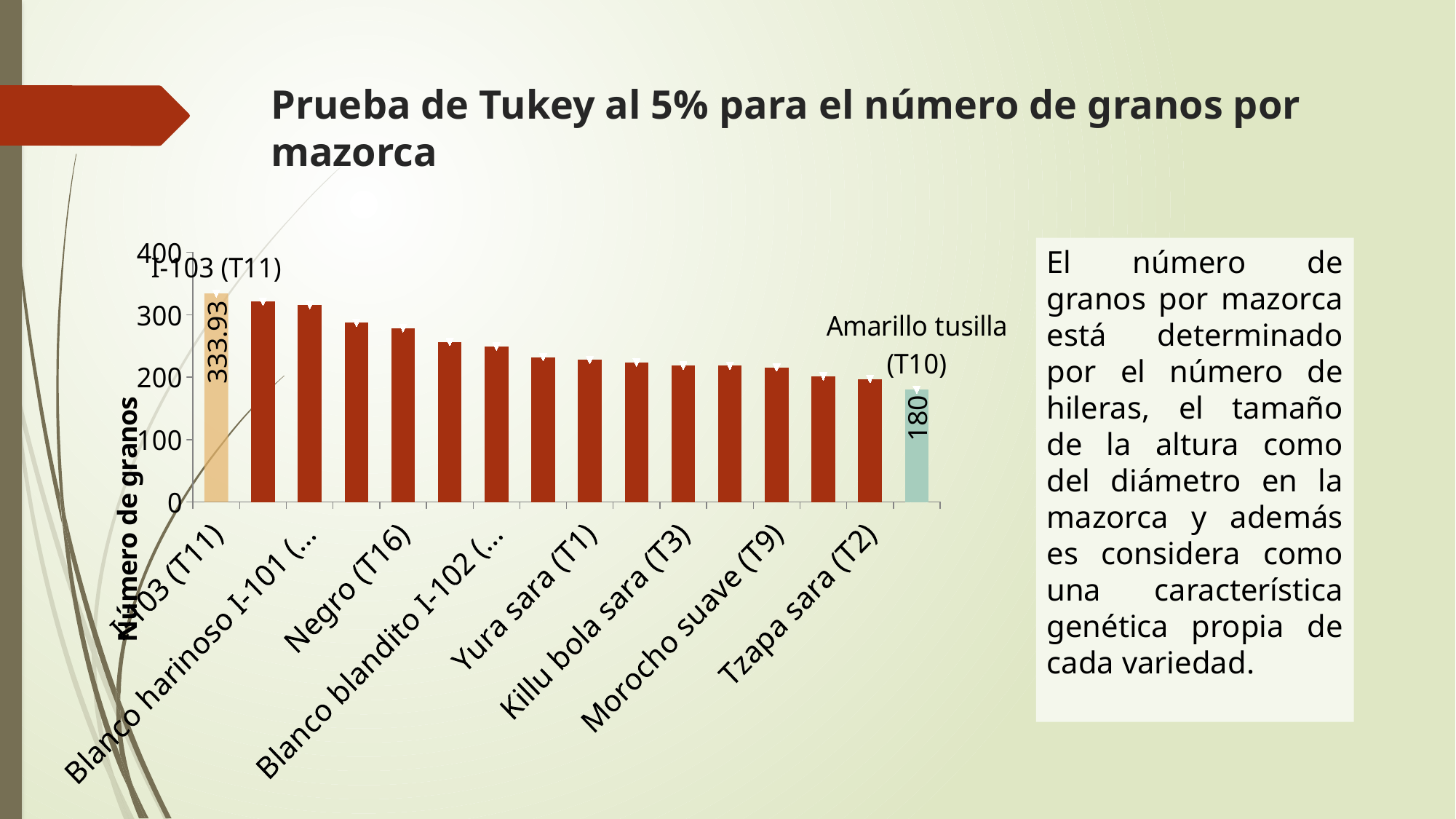
Which is larger, the value for I-103 (T11) or the value for Amarillo tusilla (T10)? I-103 (T11) What is the value for I-103 (T11)? 333.93 Which variety has the lowest number of grains per ear? Amarillo tusilla (T10) What is the value for Amarillo tusilla (T10)? 180 Is the value for Tzapa sara (T2) greater or less than 300? less Do the values rise or fall from left to right along the x axis? fall Is the value for Negro (T16) greater or less than 200? greater What is the difference between the values for I-103 (T11) and Amarillo tusilla (T10)? 153.93 Is the value for Yura sara (T1) greater or less than 300? less What is the title of the vertical axis? Número de granos Which variety has the highest number of grains per ear? I-103 (T11) What kind of chart is shown on the slide? bar chart